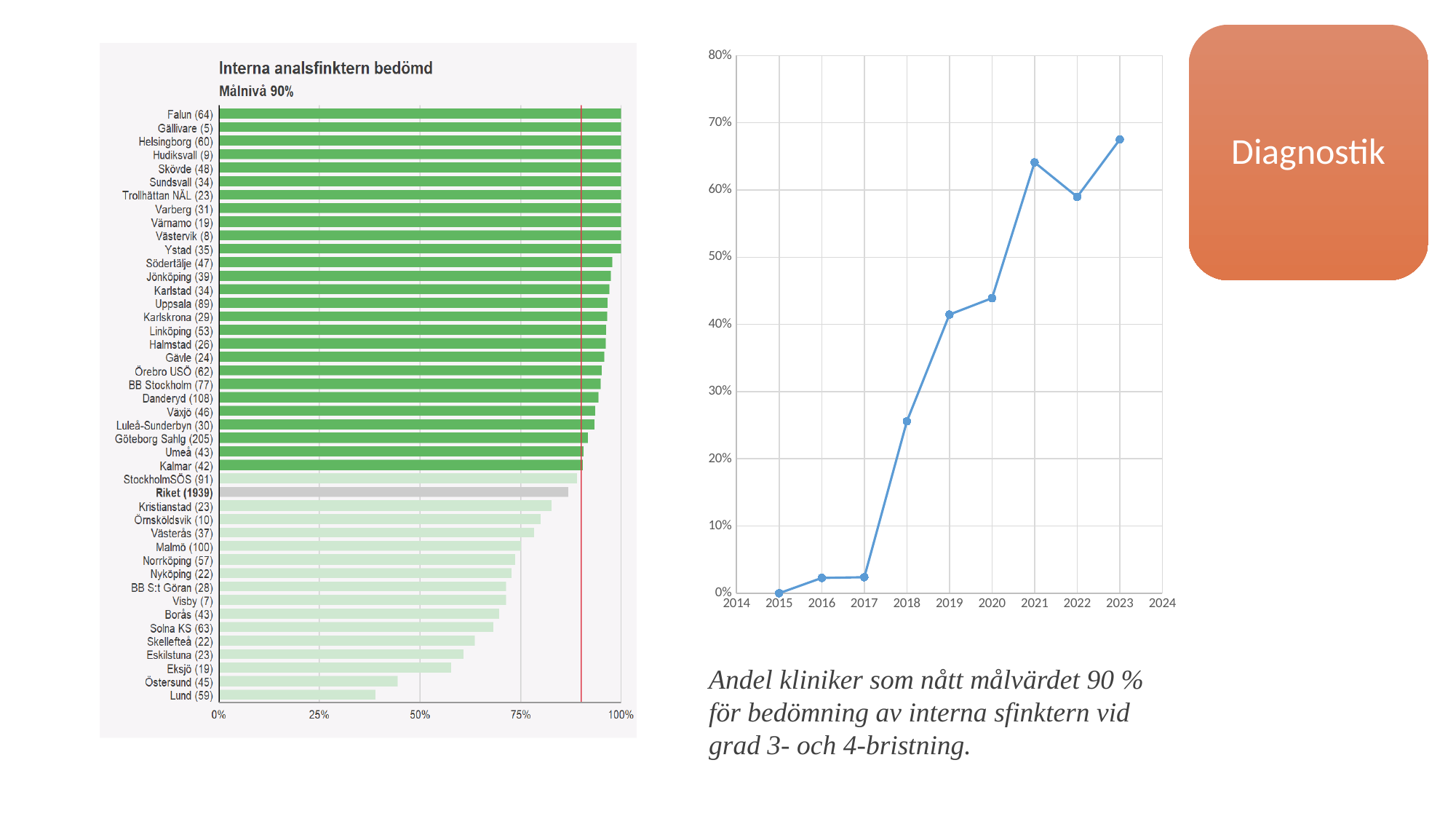
In the left chart 'Interna analsfinktern bedömd', is the value for Lund (59) greater or less than 50%? less In the right line chart, which year has the highest value? 2023 What type of chart is the chart on the right of the slide? line chart In the left chart 'Interna analsfinktern bedömd', is the value for Eskilstuna (23) greater or less than 75%? less In the right line chart, which is larger, the value for 2021 or the value for 2022? 2021 In the left chart 'Interna analsfinktern bedömd', which clinic has the lowest value? Lund (59) In the left chart 'Interna analsfinktern bedömd', what target level (Målnivå) is stated? 90% In the right line chart, is the value for 2018 greater or less than 30%? less What type of chart is the chart on the left of the slide? bar chart In the left chart 'Interna analsfinktern bedömd', which is larger, the value for Falun (64) or the value for Östersund (45)? Falun (64)